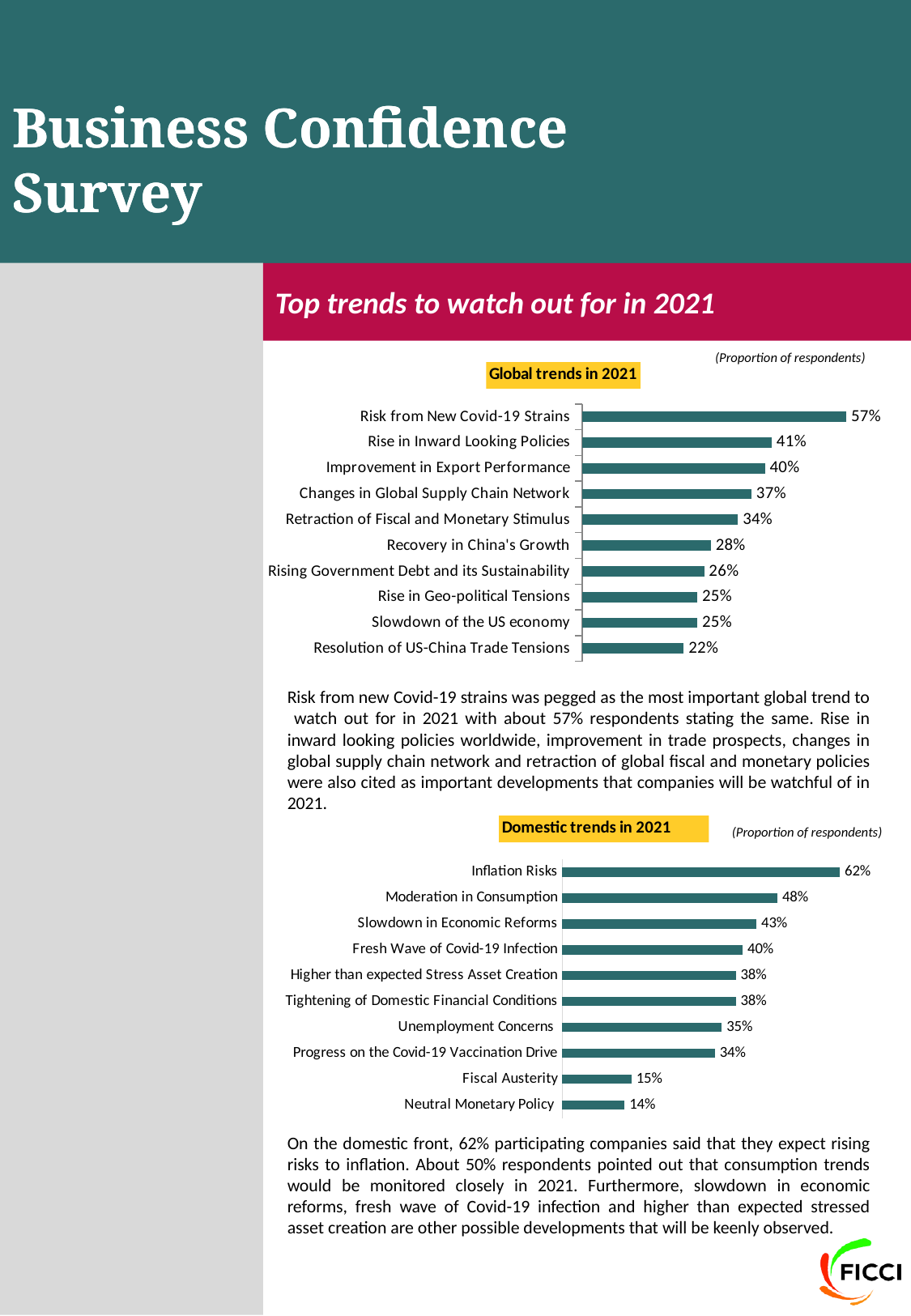
In the 'Domestic trends in 2021' chart, which is larger: Moderation in Consumption or Slowdown in Economic Reforms? Moderation in Consumption What type of chart is the 'Domestic trends in 2021' chart? Bar chart In the 'Global trends in 2021' chart, what is the difference between Rise in Inward Looking Policies and Improvement in Export Performance? 1% In the 'Domestic trends in 2021' chart, which category has the highest value? Inflation Risks What is the title of the top chart on the slide? Global trends in 2021 In the 'Domestic trends in 2021' chart, what is the value for Progress on the Covid-19 Vaccination Drive? 34% In the 'Domestic trends in 2021' chart, what is the value for Neutral Monetary Policy? 14% In the 'Domestic trends in 2021' chart, what is the difference between Inflation Risks and Fiscal Austerity? 47% In the 'Global trends in 2021' chart, which category has the lowest value? Resolution of US-China Trade Tensions In the 'Global trends in 2021' chart, how many categories are shown? 10 In the 'Global trends in 2021' chart, what is the value for Recovery in China's Growth? 28% In the 'Global trends in 2021' chart, what is the value for Risk from New Covid-19 Strains? 57%